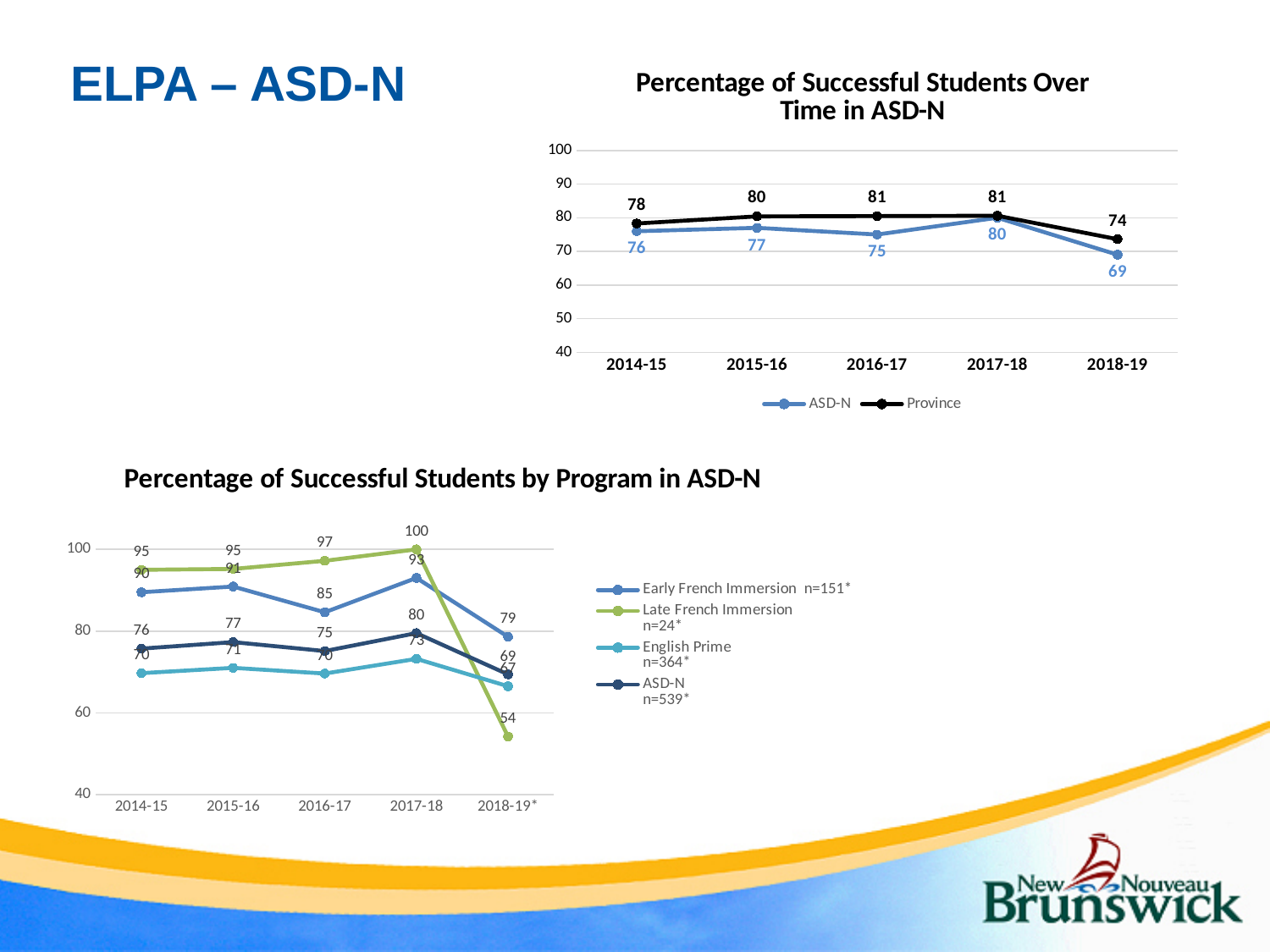
In the 'Percentage of Successful Students by Program in ASD-N' chart, what is the Late French Immersion value for 2018-19*? 54 In the 'Percentage of Successful Students Over Time in ASD-N' chart, does the ASD-N value rise or fall from 2017-18 to 2018-19? fall In the 'Percentage of Successful Students Over Time in ASD-N' chart, in which year is the ASD-N value highest? 2017-18 In the 'Percentage of Successful Students Over Time in ASD-N' chart, what is the Province value for 2016-17? 81 In the 'Percentage of Successful Students by Program in ASD-N' chart, which program has the lowest value in 2018-19*? Late French Immersion In the 'Percentage of Successful Students by Program in ASD-N' chart, how many series does the legend list? 4 In the 'Percentage of Successful Students Over Time in ASD-N' chart, what is the difference between the Province and ASD-N values in 2016-17? 6 In the 'Percentage of Successful Students by Program in ASD-N' chart, how many years are shown on the x axis? 5 In the 'Percentage of Successful Students Over Time in ASD-N' chart, how many series does the legend list? 2 In the 'Percentage of Successful Students by Program in ASD-N' chart, what is the Late French Immersion value for 2017-18? 100 What kind of chart is 'Percentage of Successful Students by Program in ASD-N'? line chart In the 'Percentage of Successful Students Over Time in ASD-N' chart, what is the ASD-N value for 2018-19? 69